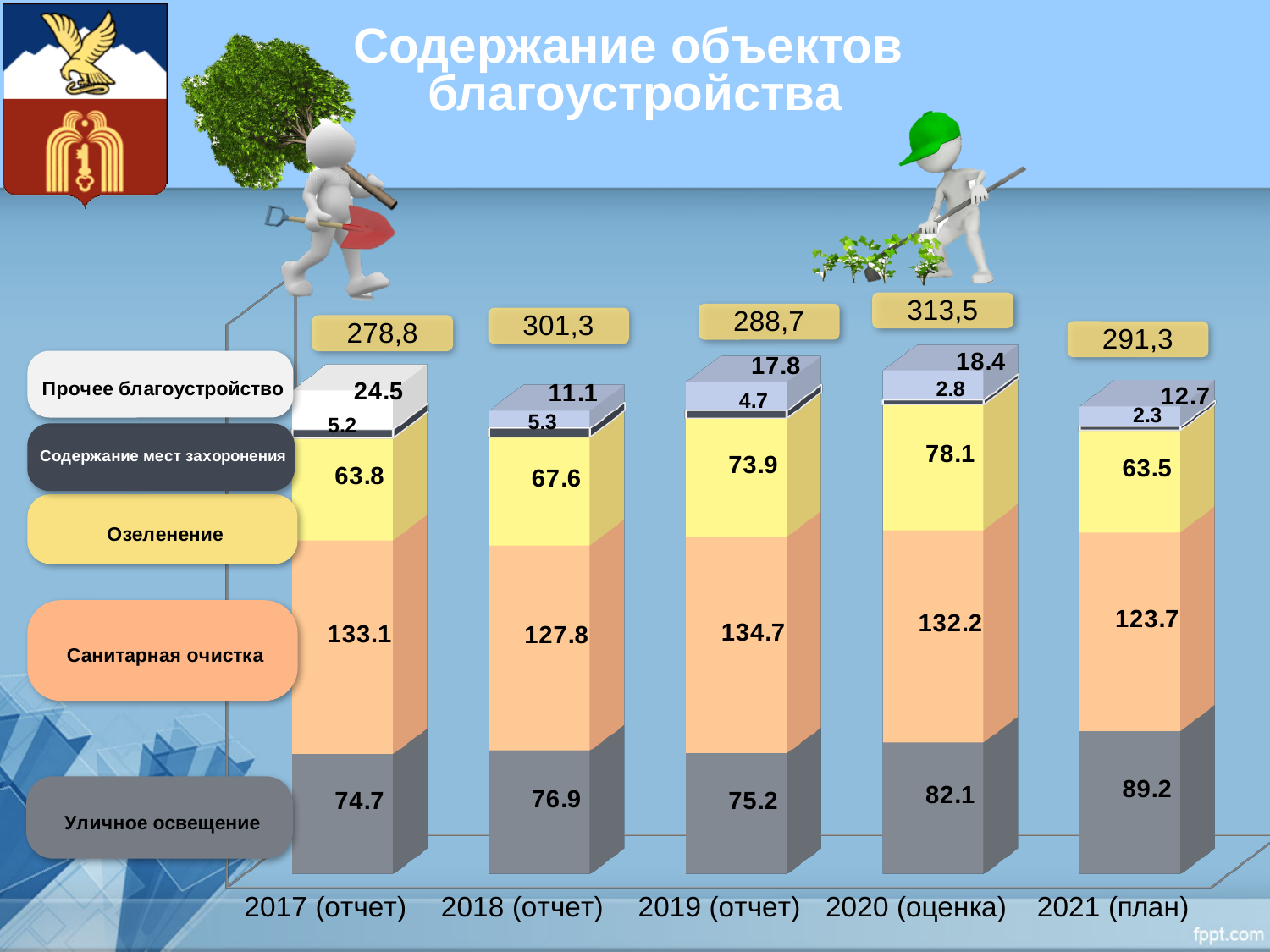
What kind of chart is shown on the slide? Stacked bar chart In which year is the value for Уличное освещение the highest? 2021 (план) How many years are shown on the x axis of the chart? 5 What is the value for Прочее благоустройство in 2017 (отчет)? 24.5 What is the value for Озеленение in 2020 (оценка)? 78.1 How many series (segments) does each stacked bar contain? 5 Which year has the larger value for Озеленение, 2018 (отчет) or 2019 (отчет)? 2019 (отчет) What is the value for Санитарная очистка in 2019 (отчет)? 134.7 Does the value for Уличное освещение rise or fall from 2019 (отчет) to 2021 (план)? Rise What is the difference between the Санитарная очистка values for 2017 (отчет) and 2021 (план)? 9.4 What is the value for Уличное освещение in 2021 (план)? 89.2 In which year is the value for Содержание мест захоронения the lowest? 2021 (план)